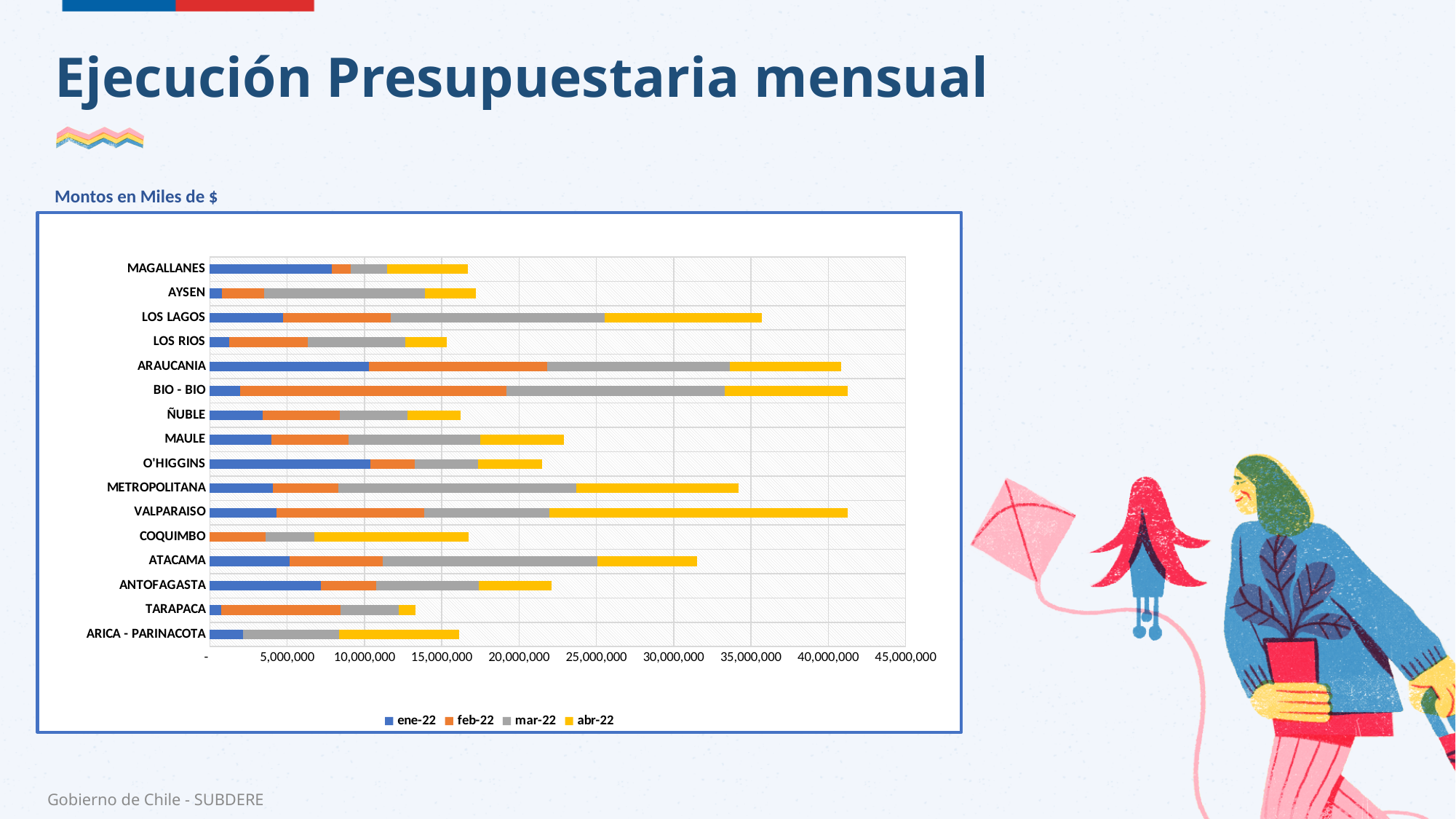
How many series does the chart legend list? 4 What are the series names listed in the legend? ene-22, feb-22, mar-22, abr-22 Is the total stacked bar for AYSEN greater or less than 20,000,000? less Is the total stacked bar for LOS LAGOS greater or less than 30,000,000? greater Which region has the larger total stacked bar, LOS LAGOS or AYSEN? LOS LAGOS What kind of chart is shown on the slide? Stacked bar chart Which region has the shortest total stacked bar? TARAPACA Which region has the larger total stacked bar, ARAUCANIA or MAULE? ARAUCANIA How many regions (categories) are plotted on the chart? 16 What unit note is shown above the chart? Montos en Miles de $ Is the total stacked bar for COQUIMBO greater or less than 20,000,000? less